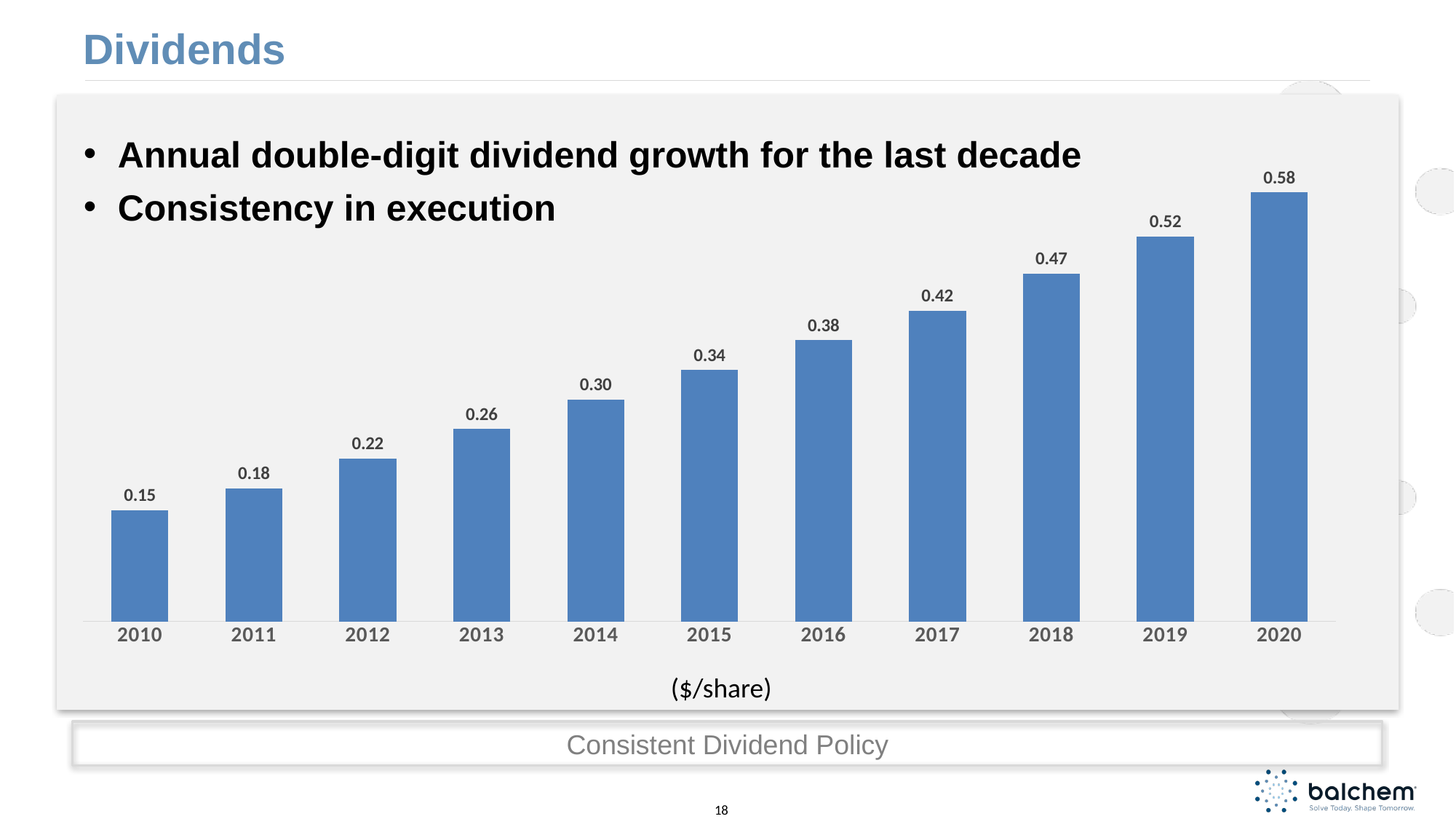
What is the difference between the dividend per share in 2020 and in 2010? 0.43 Which year has a larger dividend per share, 2013 or 2016? 2016 Do the dividend values rise or fall from 2010 to 2020? Rise What is the dividend per share shown for 2015? 0.34 Which year has the lowest dividend per share? 2010 What kind of chart is shown on the slide? Bar chart What unit label is shown below the x axis of the chart? ($/share) What is the dividend per share shown for 2010? 0.15 How many years are shown on the x axis of the chart? 11 What is the dividend per share shown for 2018? 0.47 What is the difference between the dividend per share in 2019 and in 2018? 0.05 Which year has the highest dividend per share? 2020